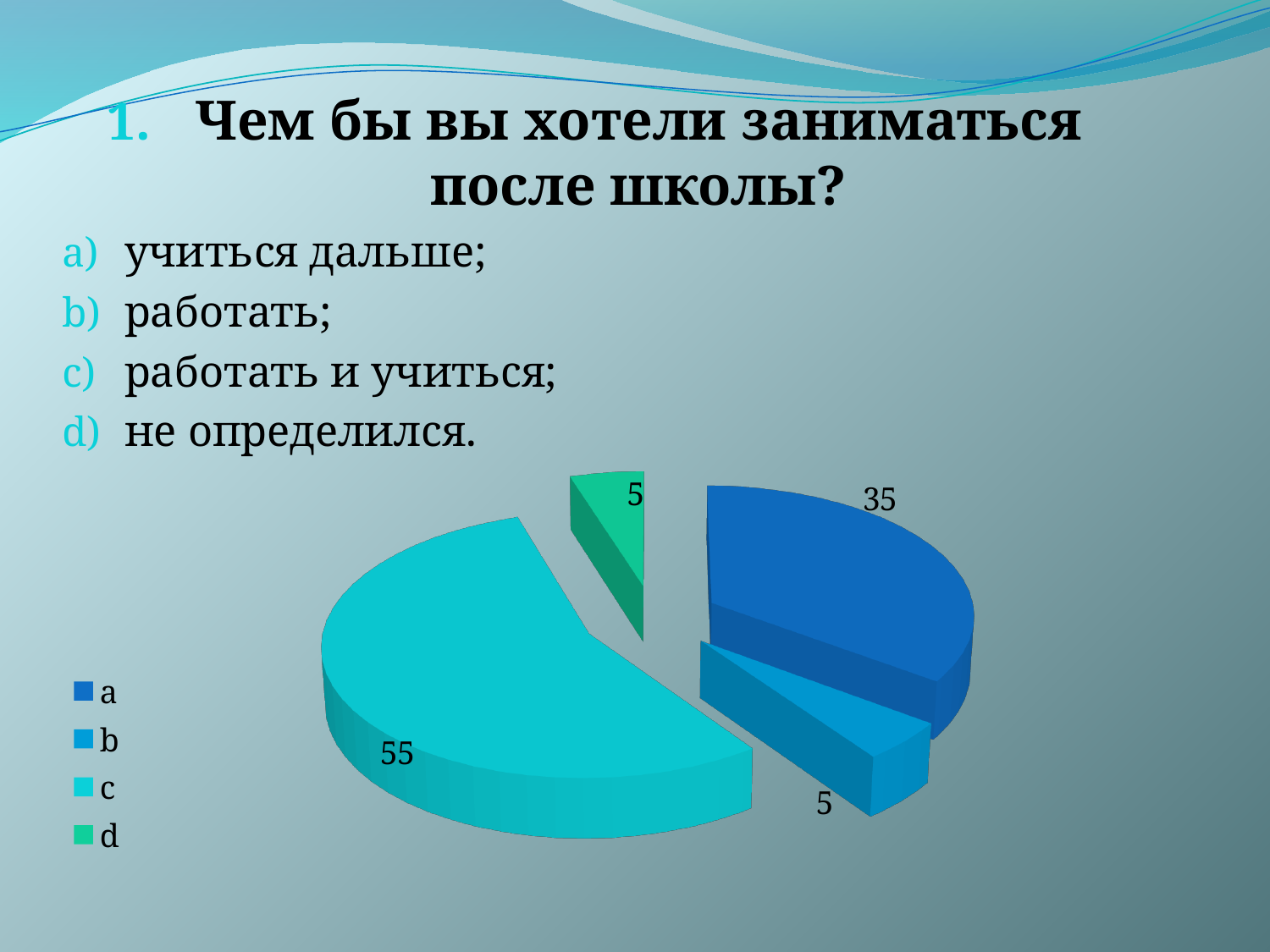
Which category has the largest slice in the pie chart? c What is the difference between the values for c and a? 20 What is the value for category d in the pie chart? 5 How many entries does the legend list? 4 What is the value for category a in the pie chart? 35 What is the value for category b in the pie chart? 5 What colour is the slice for category d? green How many slices does the pie chart have? 4 Which is larger, the value for a or the value for b? a What is the value for category c in the pie chart? 55 What share of the pie does category c represent? 55% What kind of chart is shown on the slide? pie chart